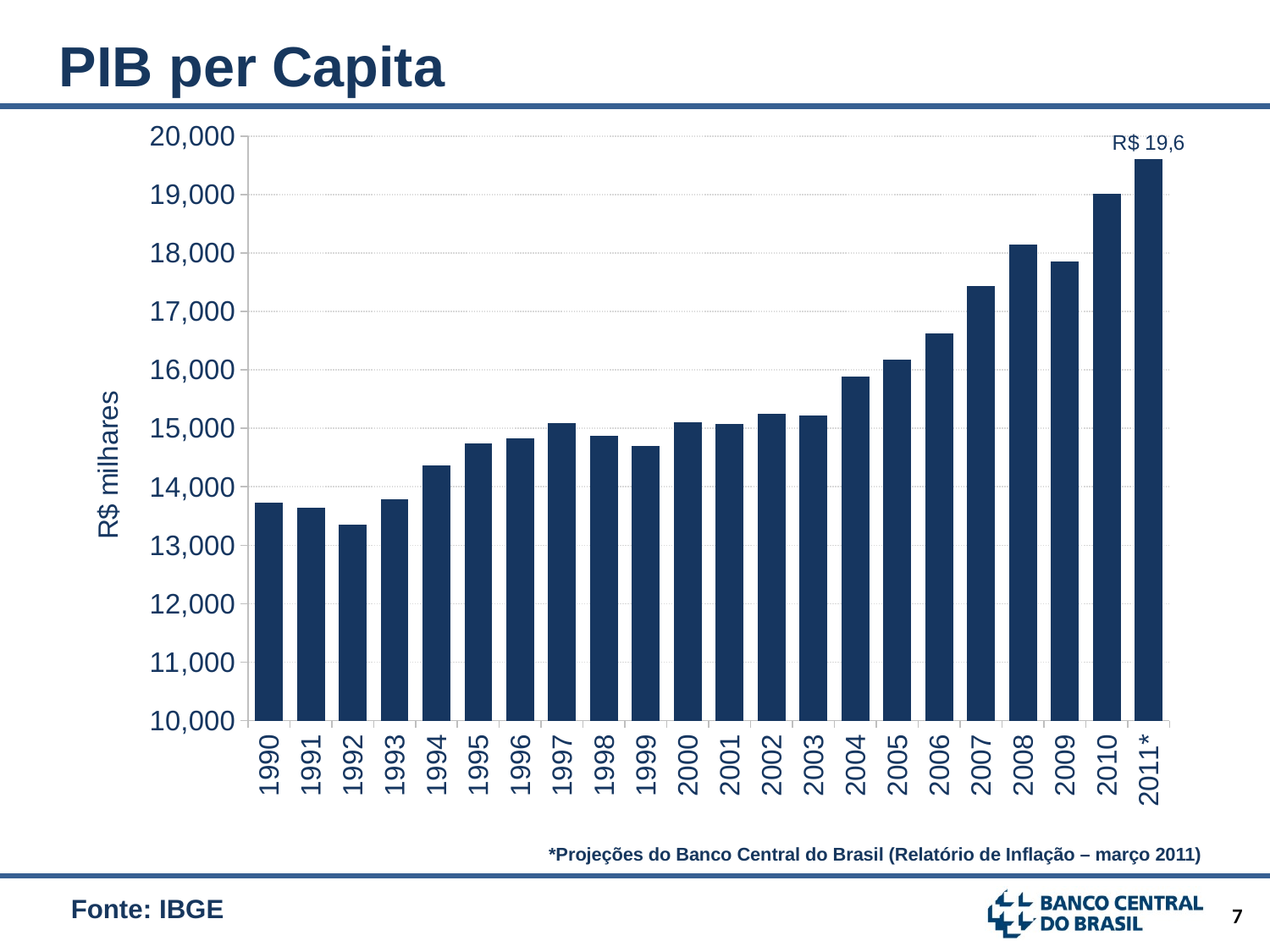
Which year has the lowest PIB per Capita in the chart? 1992 Which year has the highest PIB per Capita in the chart? 2011* Which year has a higher PIB per Capita, 2008 or 2009? 2008 Is the PIB per Capita value for 2008 greater or less than 18,000? greater How many years (bars) are shown in the PIB per Capita chart? 22 Overall, do the PIB per Capita values rise or fall from 1990 to 2011*? Rise What kind of chart is used to show PIB per Capita? Bar chart Is the PIB per Capita value for 1992 greater or less than 14,000? less Is the PIB per Capita value for 2004 greater or less than 16,000? less What value is labelled on the bar for 2011* in the PIB per Capita chart? R$ 19,6 What source is cited for the PIB per Capita chart? IBGE What is the label on the vertical axis of the PIB per Capita chart? R$ milhares